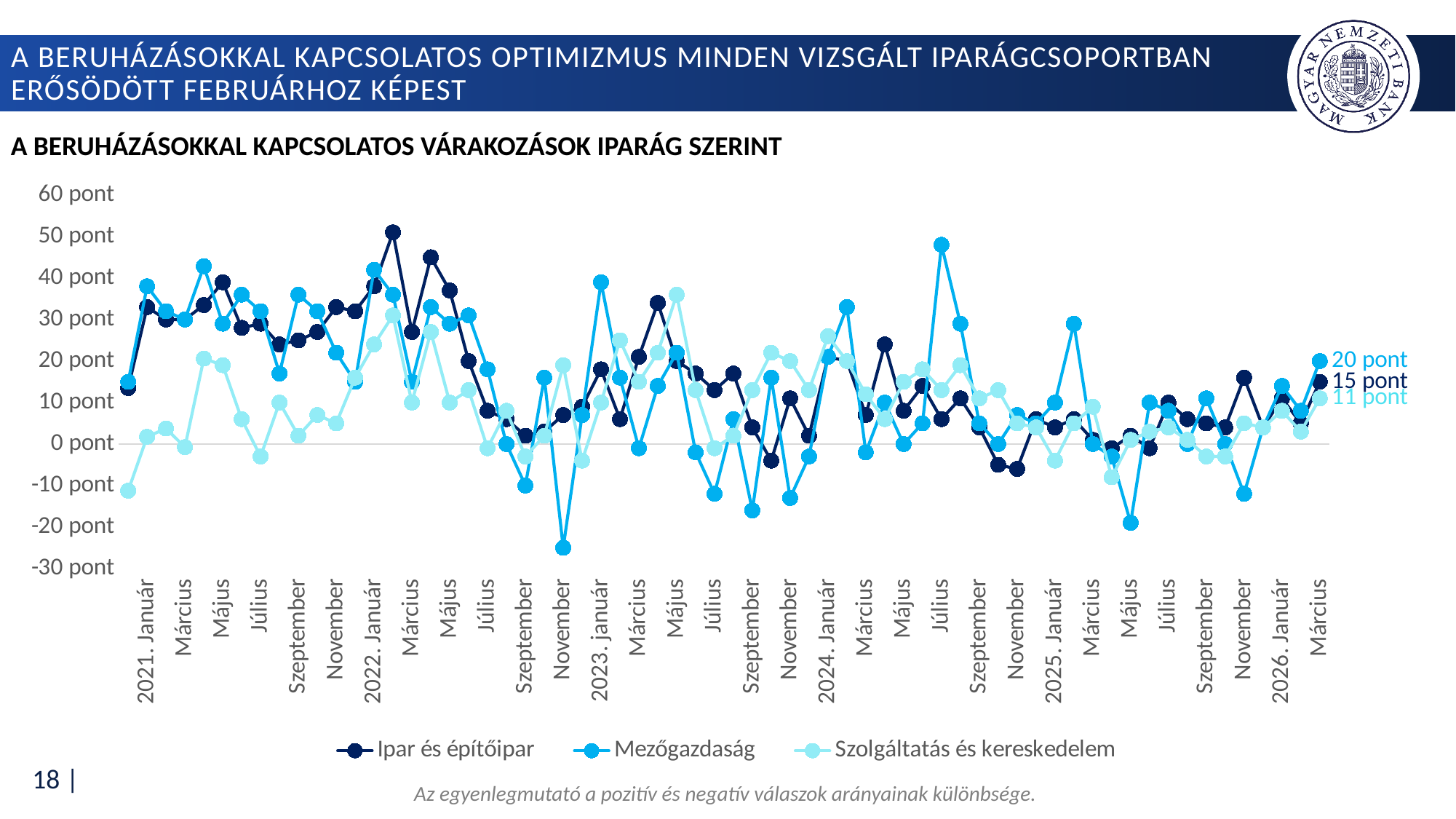
At the last data point, what is the difference between the Ipar és építőipar value and the Szolgáltatás és kereskedelem value? 4 pont At the last data point, what is the difference between the Mezőgazdaság value and the Szolgáltatás és kereskedelem value? 9 pont What is the latest value (Március 2026) for Szolgáltatás és kereskedelem? 11 pont What is the latest value (Március 2026) for Mezőgazdaság? 20 pont How many series does the legend list? 3 Is the value for Mezőgazdaság in November 2022 greater or less than -20 pont? less At the last data point, which series has the highest value? Mezőgazdaság What is the title of the chart? A BERUHÁZÁSOKKAL KAPCSOLATOS VÁRAKOZÁSOK IPARÁG SZERINT What is the latest value (Március 2026) for Ipar és építőipar? 15 pont At the last data point, which is larger: the value for Ipar és építőipar or the value for Szolgáltatás és kereskedelem? Ipar és építőipar What kind of chart is shown on the slide? line chart Is the highest value reached by Ipar és építőipar greater or less than 40 pont? greater